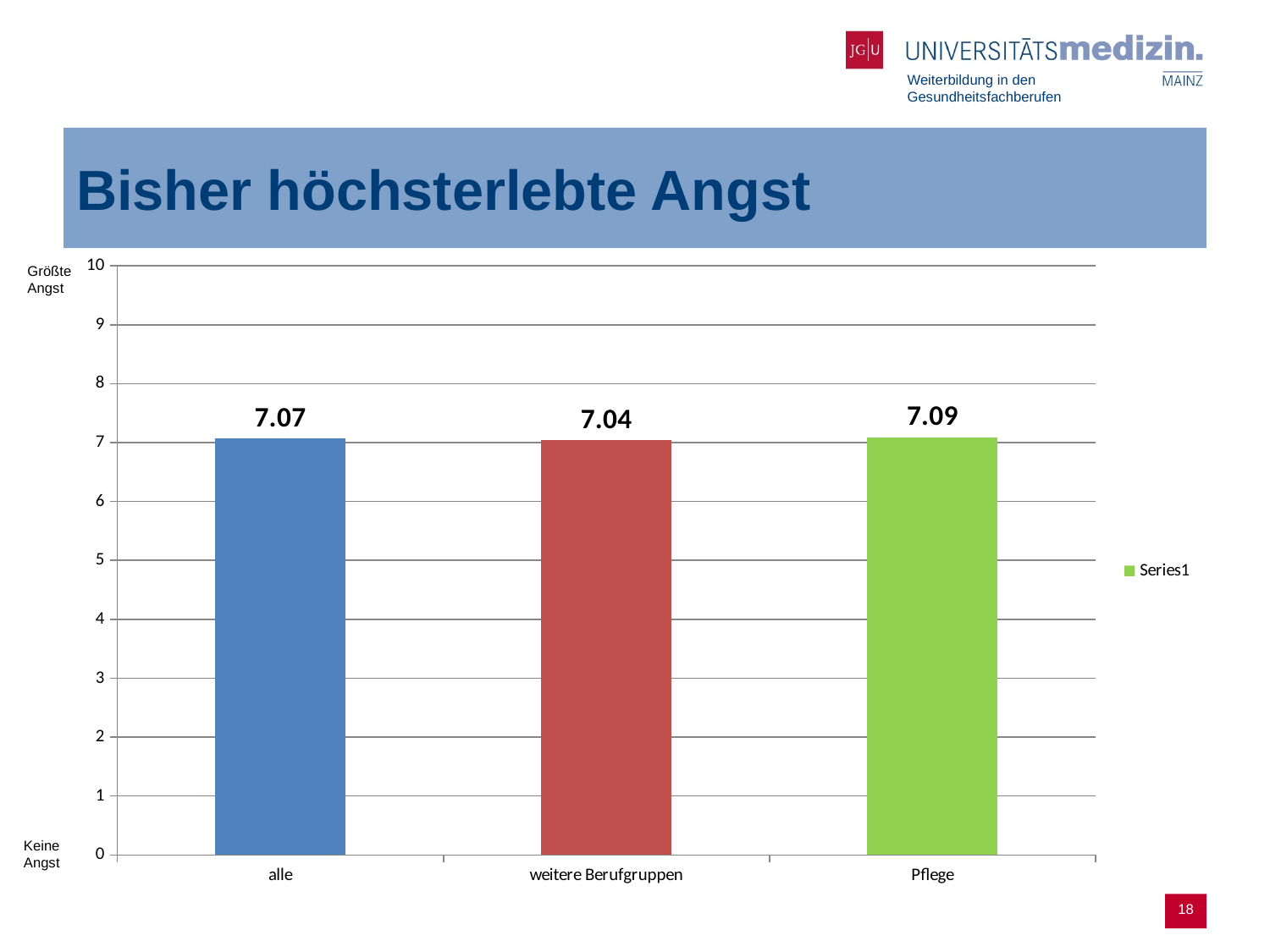
What kind of chart is shown on the slide? bar chart What is the value for "alle"? 7.07 Which category has the highest value according to the data labels? Pflege What is the value for "Pflege"? 7.09 Which category has the lowest value according to the data labels? weitere Berufgruppen What is the difference between the values for "Pflege" and "weitere Berufgruppen"? 0.05 Based on the data labels, which is larger: the value for "Pflege" or the value for "alle"? Pflege Is the value for "alle" greater or less than 8? less How many categories are shown on the x axis? 3 What is the value for "weitere Berufgruppen"? 7.04 What is the title of the slide containing the chart? Bisher höchsterlebte Angst What is the difference between the values for "alle" and "weitere Berufgruppen"? 0.03